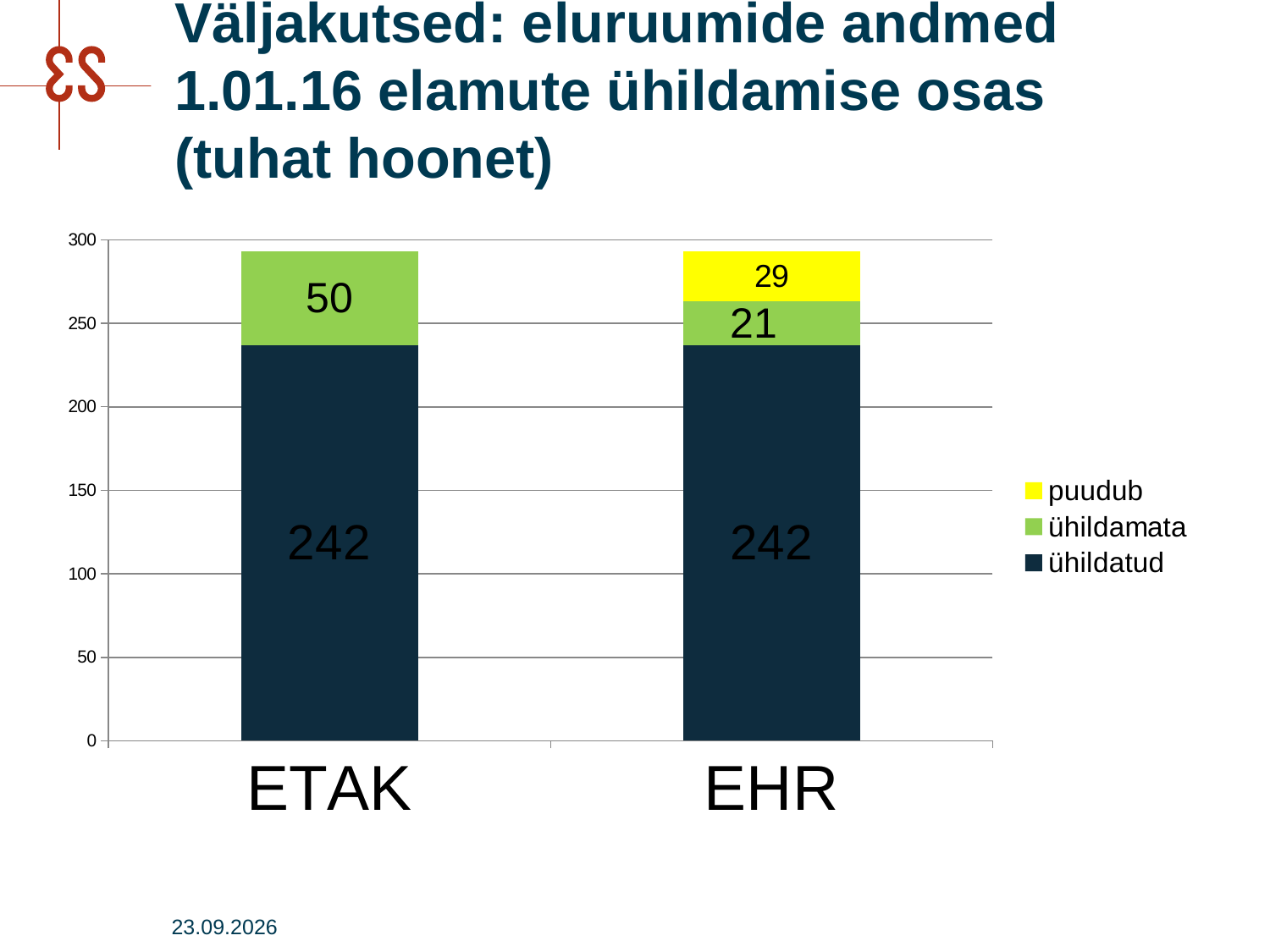
How many series does the legend list? 3 What is the ühildamata value for ETAK? 50 What is the ühildatud value for ETAK? 242 Which series is shown in yellow in the legend? puudub How many categories are shown on the x axis? 2 What is the difference between the ühildamata values for ETAK and EHR? 29 What is the total of the stacked bar for ETAK? 292 What is the puudub value for EHR? 29 What is the total of the stacked bar for EHR? 292 What is the ühildamata value for EHR? 21 What kind of chart is shown on the slide? Stacked bar chart Which category has the larger ühildamata value, ETAK or EHR? ETAK